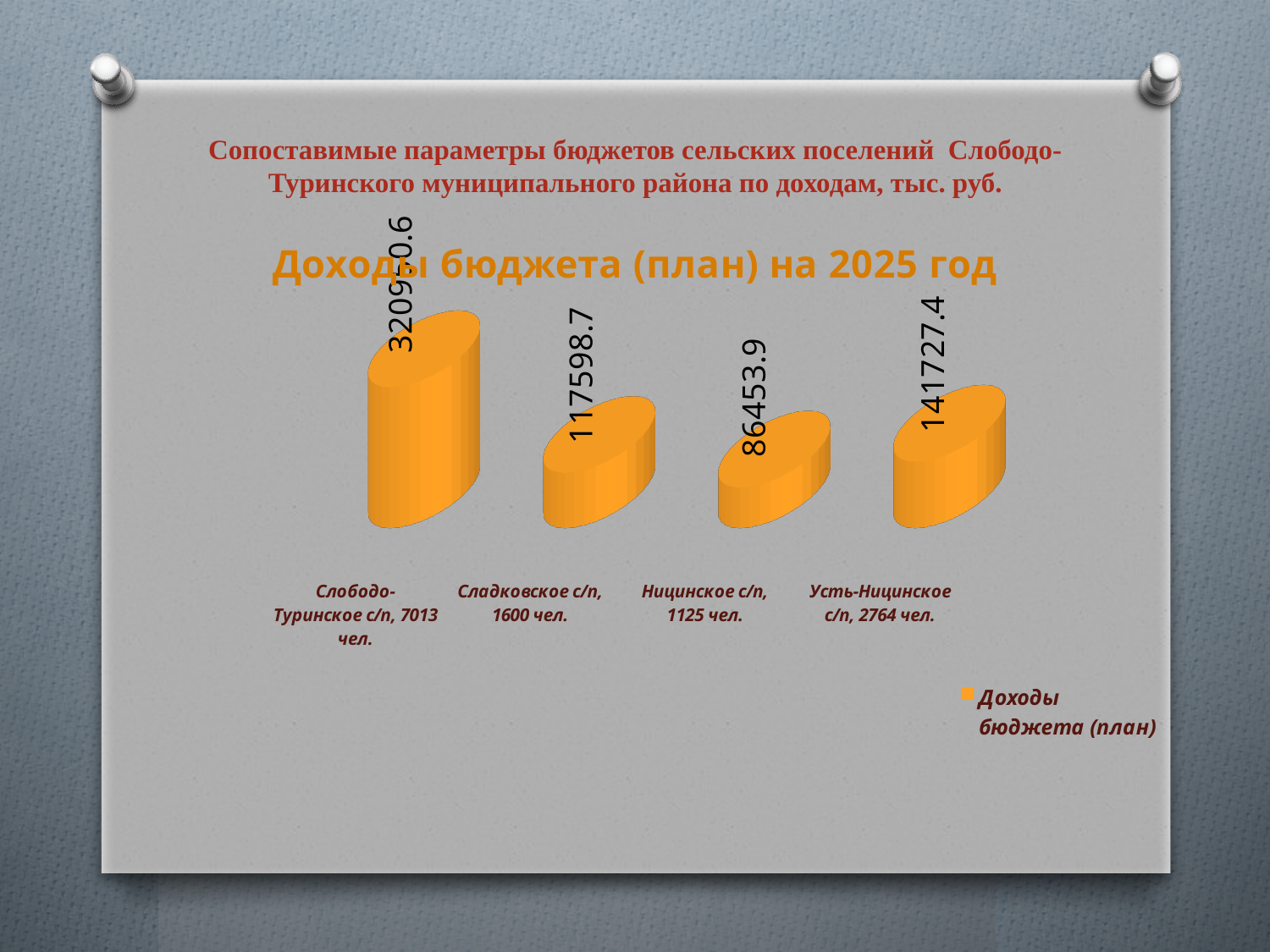
Which is larger, the value for Сладковское с/п or the value for Усть-Ницинское с/п? Усть-Ницинское с/п How many categories are shown in the chart? 4 What is the value for Сладковское с/п, 1600 чел.? 117598.7 Which category has the highest value? Слободо-Туринское с/п, 7013 чел. What is the title of the chart? Доходы бюджета (план) на 2025 год How many series does the legend list? 1 What is the difference between the values for Усть-Ницинское с/п and Сладковское с/п? 24128.7 Which category has the lowest value? Ницинское с/п, 1125 чел. What is the value for Усть-Ницинское с/п, 2764 чел.? 141727.4 What is the difference between the values for Сладковское с/п and Ницинское с/п? 31144.8 What kind of chart is shown? Bar chart What is the value for Ницинское с/п, 1125 чел.? 86453.9